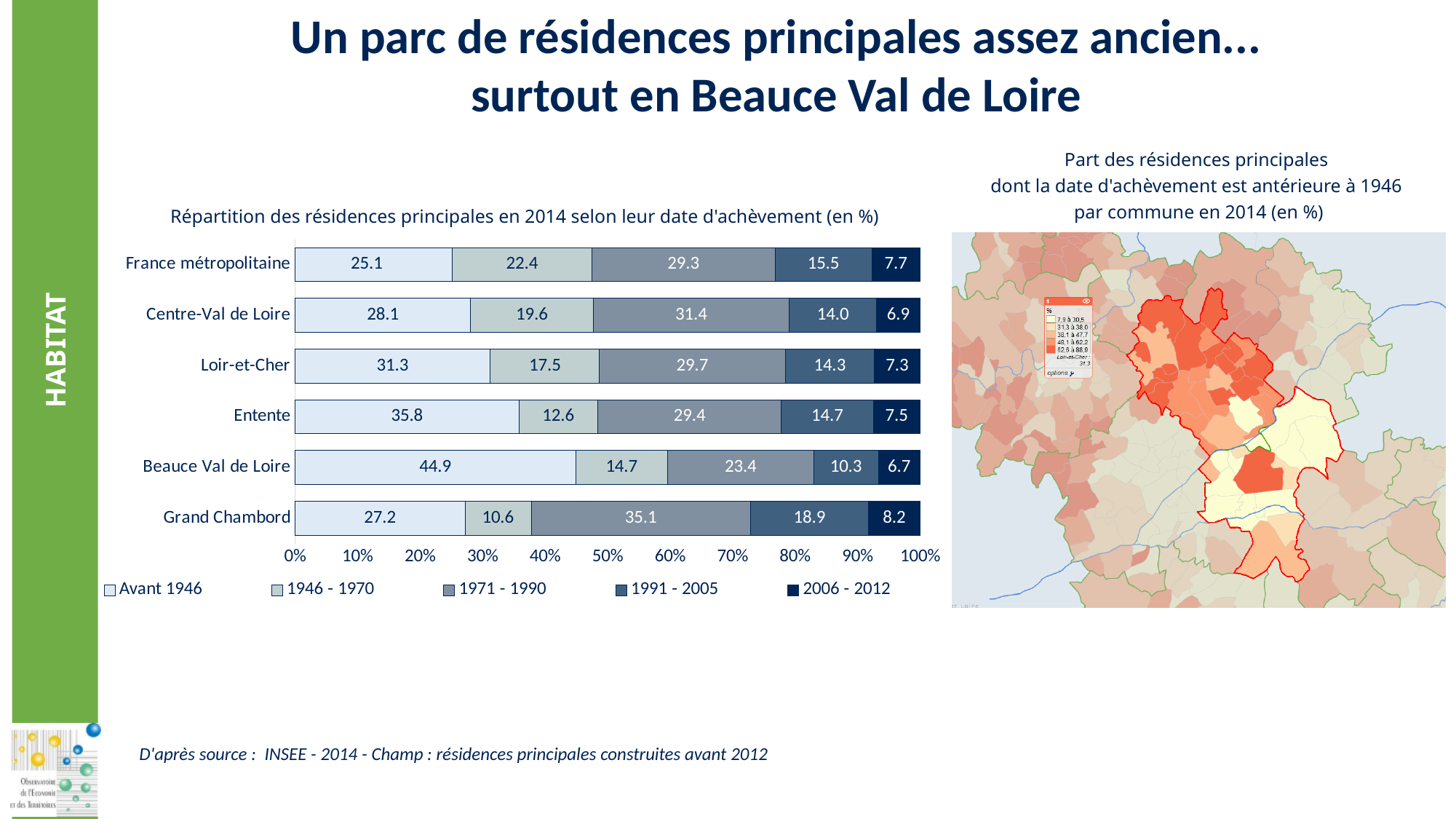
How many series does the legend of the bar chart list? 5 How many territories are shown in the bar chart? 6 In the bar chart, what is the difference between the 'Avant 1946' values for Beauce Val de Loire and France métropolitaine? 19.8 In the bar chart, which territory has the highest 'Avant 1946' value? Beauce Val de Loire In the bar chart, what is the value of '1971 - 1990' for Grand Chambord? 35.1 In the bar chart, what is the value of 'Avant 1946' for Beauce Val de Loire? 44.9 In the bar chart, which is larger: the '2006 - 2012' value for Grand Chambord or for Centre-Val de Loire? Grand Chambord In the bar chart, which territory has the highest '2006 - 2012' value? Grand Chambord In the bar chart, which territory has the lowest '1946 - 1970' value? Grand Chambord What is the title of the bar chart? Répartition des résidences principales en 2014 selon leur date d'achèvement (en %) What kind of chart is used to show the répartition des résidences principales selon leur date d'achèvement? Stacked bar chart In the bar chart, what is the value of '1991 - 2005' for Entente? 14.7